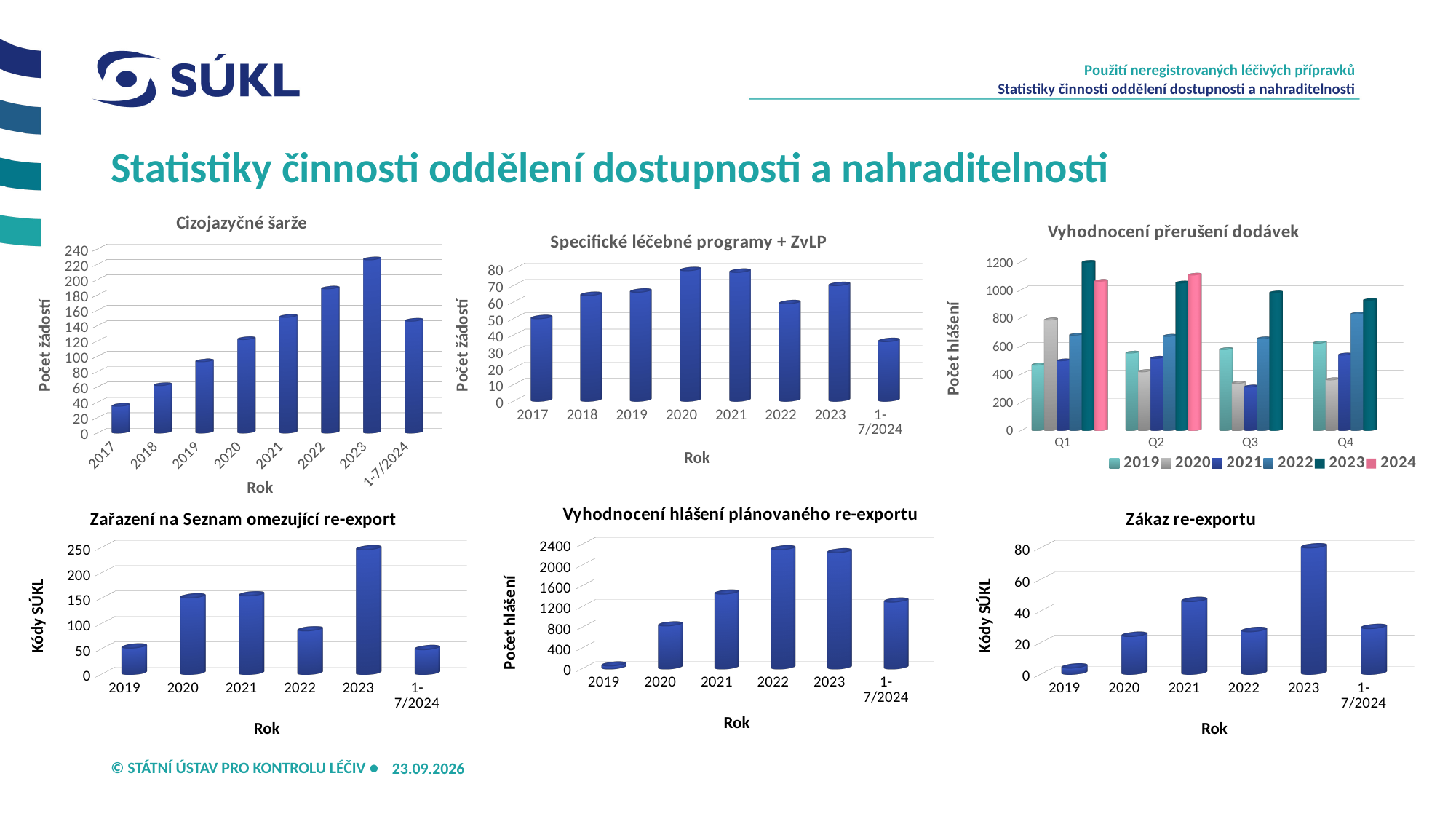
In the 'Specifické léčebné programy + ZvLP' chart, which category has the lowest value? 1-7/2024 How many categories are shown on the x axis of the 'Vyhodnocení hlášení plánovaného re-exportu' chart? 6 How many series does the legend of the 'Vyhodnocení přerušení dodávek' chart list? 6 In the 'Vyhodnocení hlášení plánovaného re-exportu' chart, is the value for 2019 greater or less than 400? less In the 'Zákaz re-exportu' chart, which year has the highest value? 2023 In the 'Vyhodnocení přerušení dodávek' chart, is the 2023 value for Q1 greater or less than 1000? greater In the 'Cizojazyčné šarže' chart, which year has the lowest value? 2017 In the 'Zařazení na Seznam omezující re-export' chart, which year has the highest value? 2023 In the 'Specifické léčebné programy + ZvLP' chart, is the value for 2017 greater or less than 60? less In the 'Cizojazyčné šarže' chart, which year has the highest number of requests? 2023 In the 'Vyhodnocení přerušení dodávek' chart, which is larger for Q3: 2019 or 2021? 2019